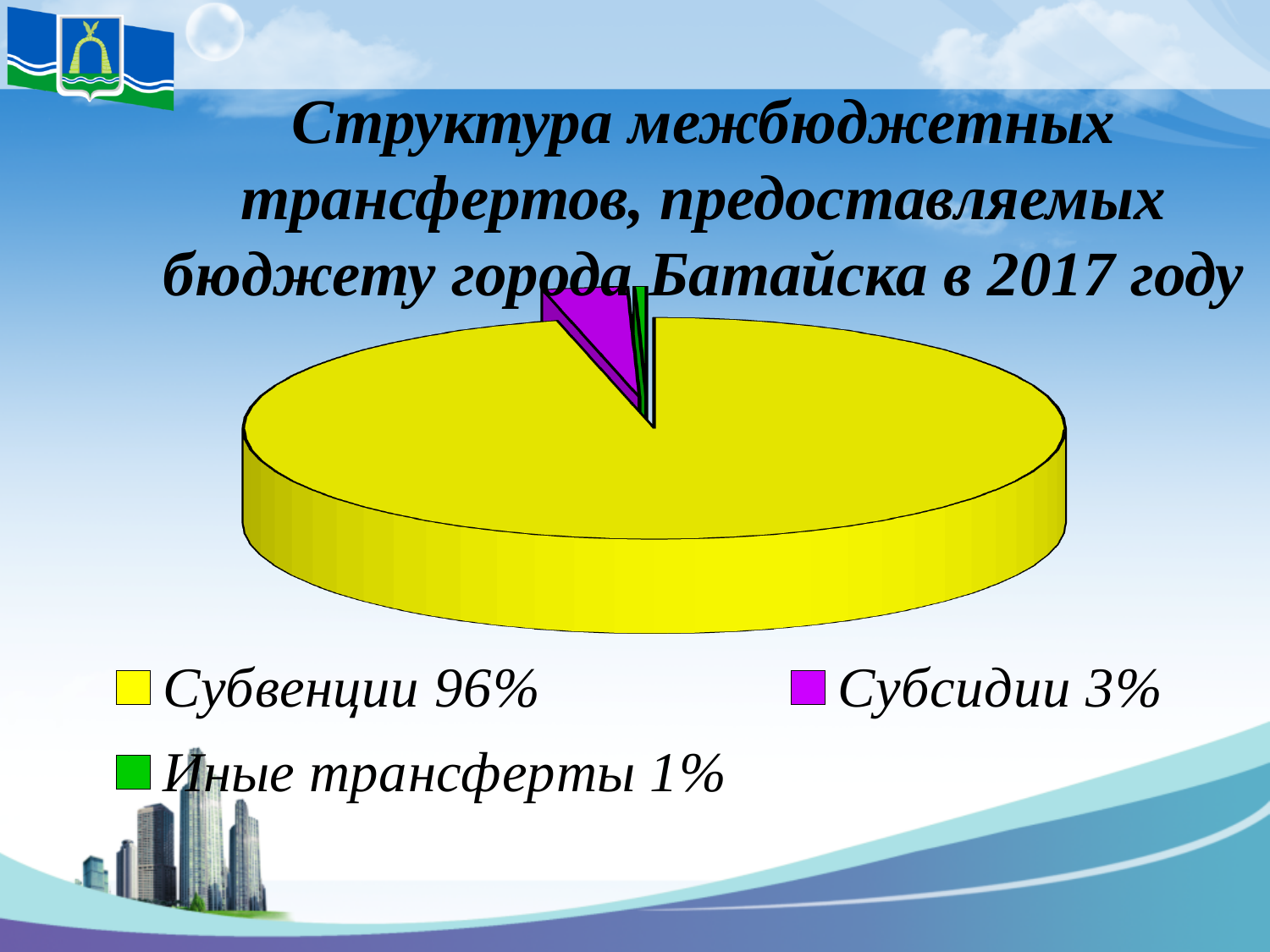
What share of the pie does Субсидии have? 3% What colour is the slice for Субвенции? Yellow Which category has the smallest slice of the pie? Иные трансферты What is the difference in percentage points between Субсидии and Иные трансферты? 2 What is the difference in percentage points between Субвенции and Субсидии? 93 What share of the pie does Субвенции have? 96% Which year does the chart title say the data refers to? 2017 Which is larger, the share for Субсидии or the share for Иные трансферты? Субсидии What kind of chart is shown on the slide? Pie chart What share of the pie does Иные трансферты have? 1% Which category has the largest slice of the pie? Субвенции How many categories does the pie chart show? 3